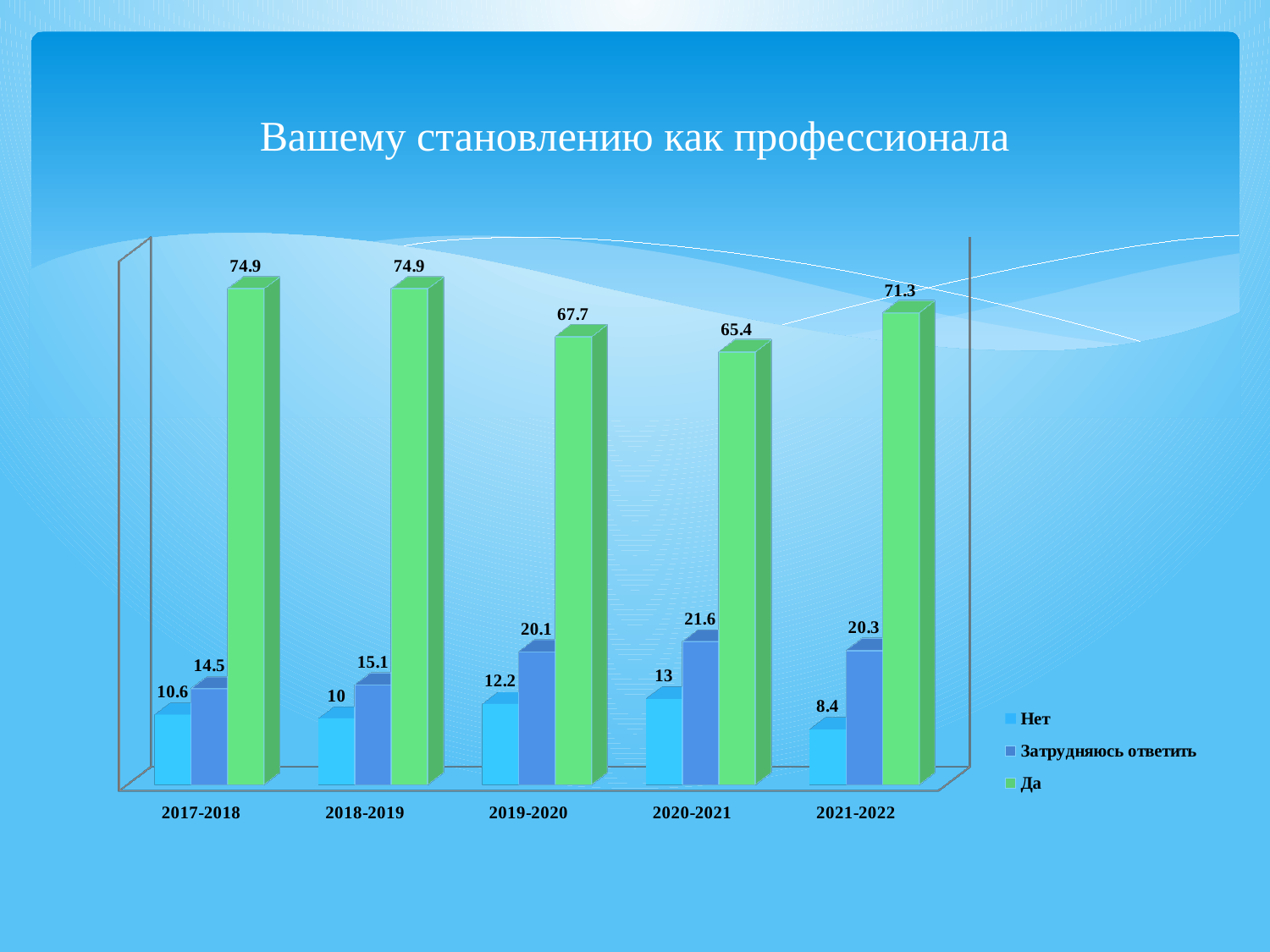
What is the value for "Нет" in 2021-2022? 8.4 In which year is the "Затрудняюсь ответить" value highest? 2020-2021 What is the value for "Затрудняюсь ответить" in 2020-2021? 21.6 What kind of chart is shown on the slide? bar chart In which year is the "Да" value lowest? 2020-2021 How many series does the legend list? 3 How many year categories are shown on the x axis? 5 What is the difference between the "Да" values for 2017-2018 and 2021-2022? 3.6 Which series is shown in green in the legend? Да Which is larger: "Нет" in 2019-2020 or "Нет" in 2020-2021? 2020-2021 What is the value for "Да" in 2019-2020? 67.7 In which year is the "Нет" value lowest? 2021-2022